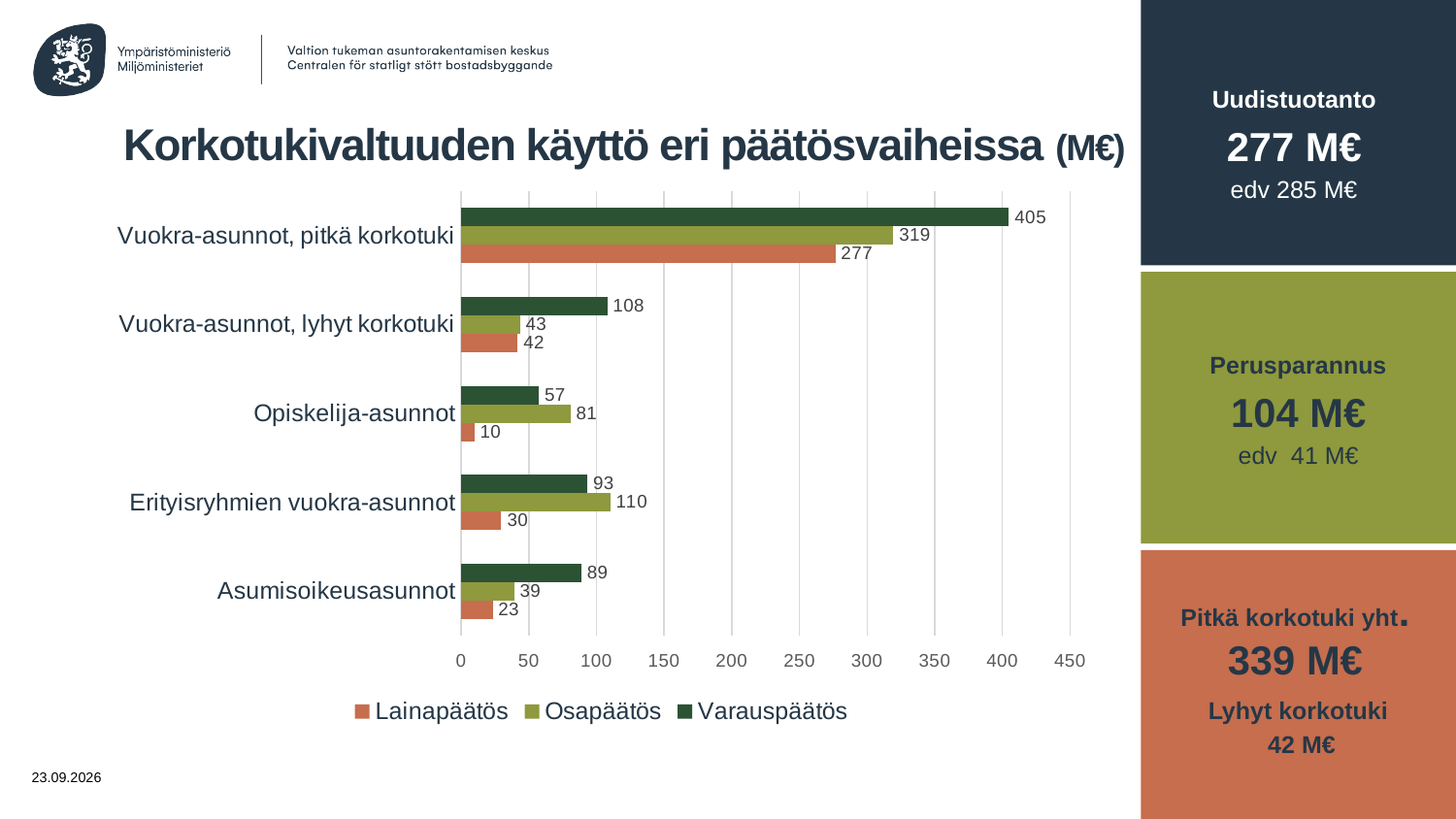
What is the Varauspäätös value for Vuokra-asunnot, pitkä korkotuki? 405 How many series does the legend list? 3 How many categories are shown on the chart? 5 For Opiskelija-asunnot, which is larger: the Osapäätös value or the Varauspäätös value? Osapäätös Which category has the lowest Lainapäätös value? Opiskelija-asunnot What kind of chart is shown on the slide? bar chart Which category has the highest Varauspäätös value? Vuokra-asunnot, pitkä korkotuki Is the Varauspäätös value for Asumisoikeusasunnot greater or less than 100? less What is the Lainapäätös value for Opiskelija-asunnot? 10 What is the difference between the Osapäätös and Lainapäätös values for Vuokra-asunnot, pitkä korkotuki? 42 Which series is shown in orange in the legend? Lainapäätös What is the Osapäätös value for Erityisryhmien vuokra-asunnot? 110